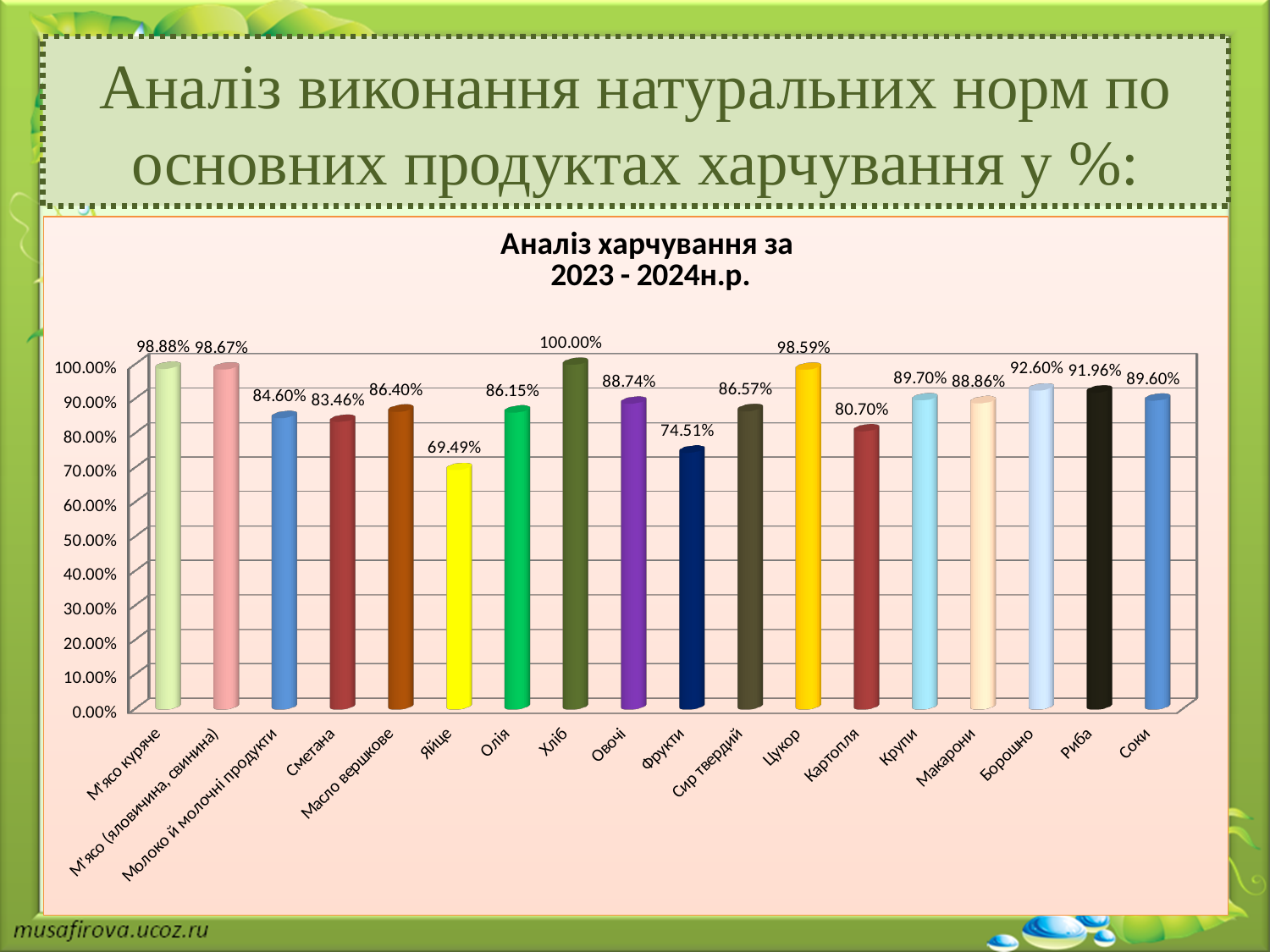
Which category has the lowest value? Яйце What kind of chart is shown on the slide? Bar chart What is the title of the chart? Аналіз харчування за 2023 - 2024н.р. What is the value for Яйце? 69.49% What is the difference between the values for Цукор and Картопля? 17.89% Which is larger, the value for Фрукти or the value for Овочі? Овочі How many categories are shown on the chart? 18 What is the value for Хліб? 100.00% What is the difference between the values for Хліб and Яйце? 30.51% What is the value for Картопля? 80.70% Which category has the highest value? Хліб What is the value for Борошно? 92.60%